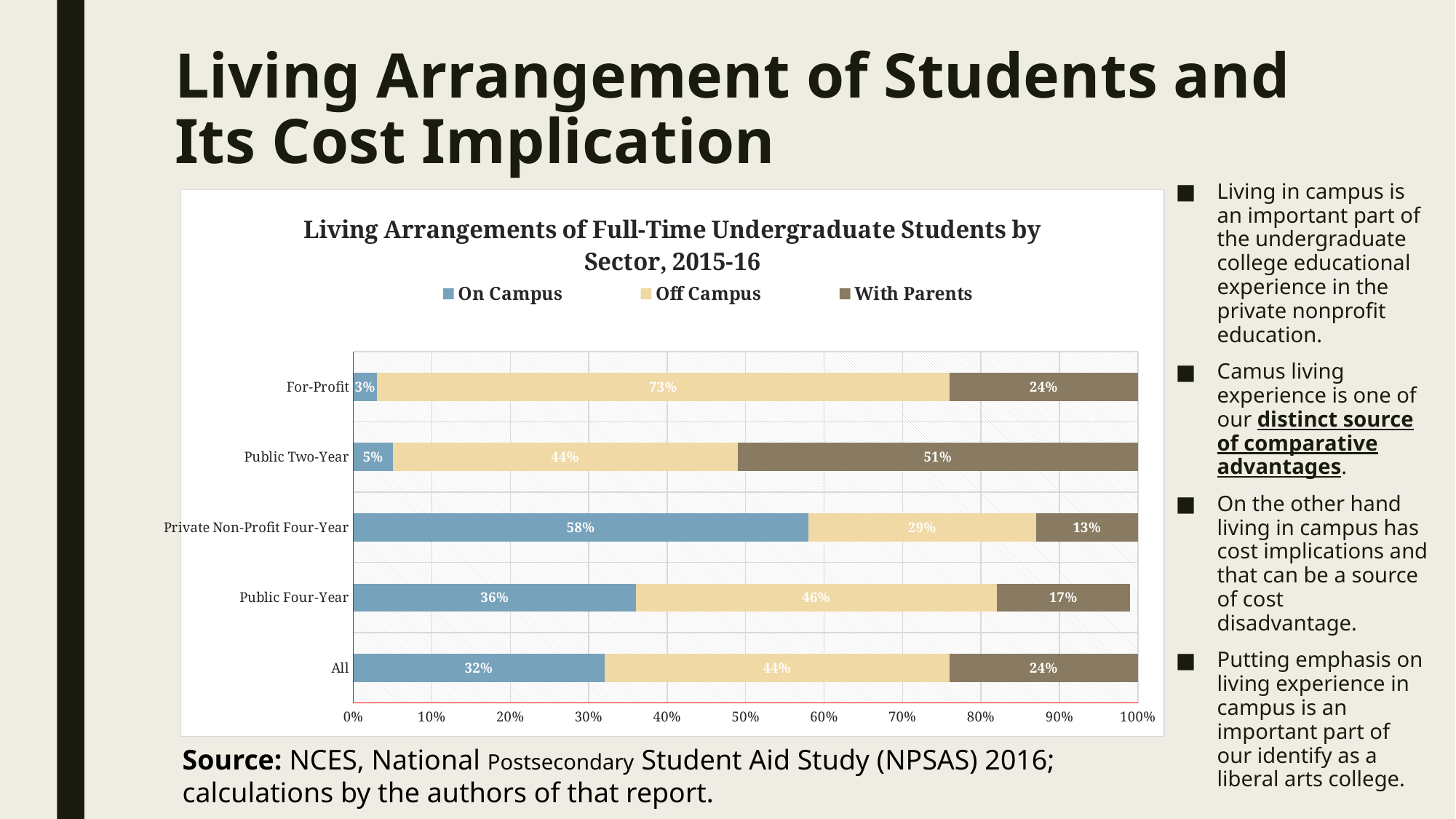
Which sector has the lowest On Campus share? For-Profit What is the total of the stacked bar for Public Four-Year? 99% How many series does the legend list? 3 What is the title of the chart? Living Arrangements of Full-Time Undergraduate Students by Sector, 2015-16 What is the Off Campus value for For-Profit? 73% What is the On Campus value for Private Non-Profit Four-Year? 58% What kind of chart is shown on the slide? Stacked bar chart What is the With Parents value for Public Two-Year? 51% How many sector categories are plotted on the chart? 5 What is the difference between the On Campus values for Private Non-Profit Four-Year and Public Four-Year? 22% Which sector has the highest On Campus share? Private Non-Profit Four-Year Which is larger: the With Parents value for Public Two-Year or for All? Public Two-Year